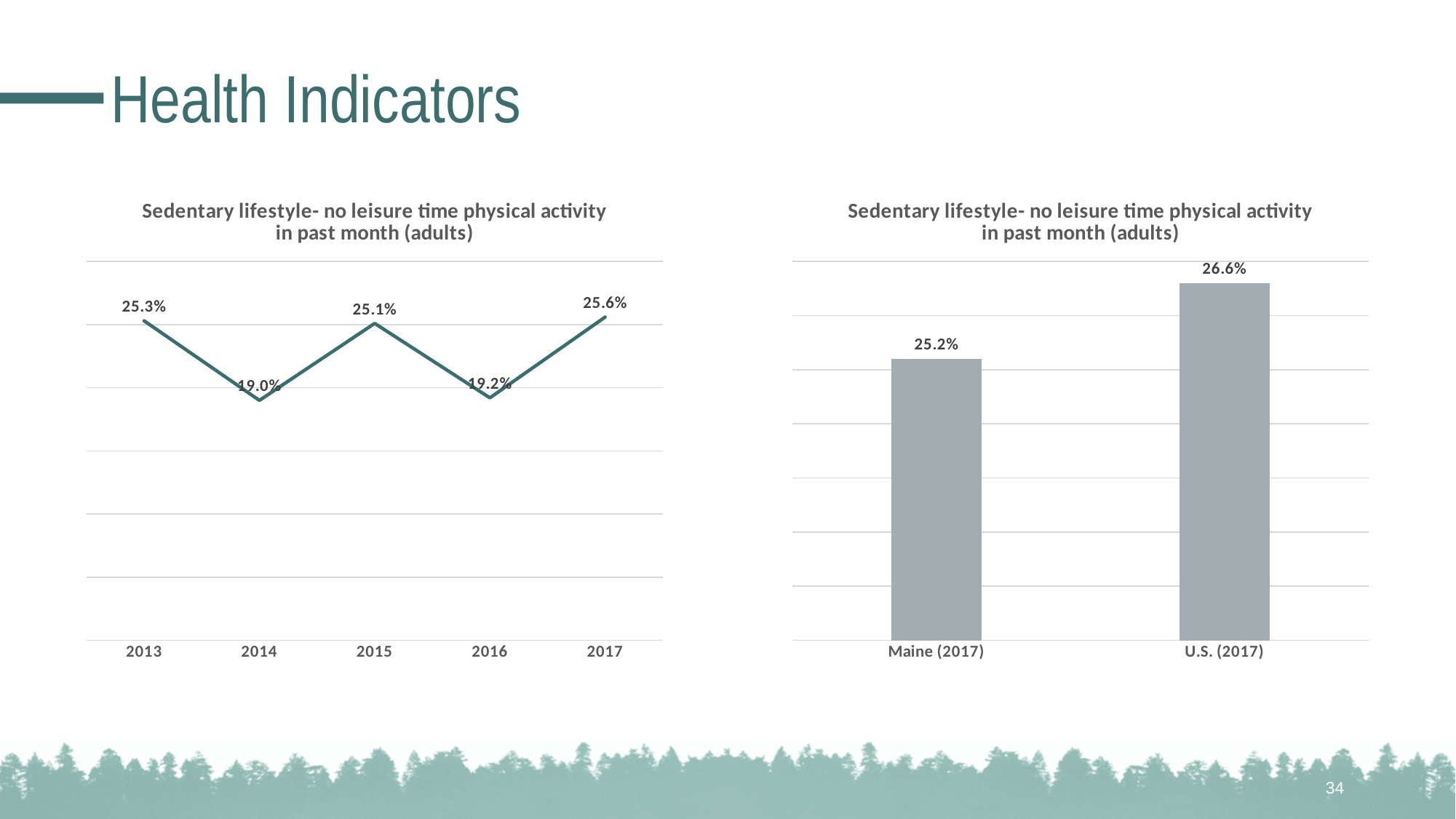
In the left chart, which year has the lowest value? 2014 In the left chart, does the value rise or fall from 2016 to 2017? Rise What kind of chart is the right chart? Bar chart In the left chart, what is the difference between the 2013 and 2014 values? 6.3% In the left chart, how many years are plotted on the x axis? 5 What kind of chart is the left chart? Line chart In the left chart, which year has the highest value? 2017 In the right chart, which is larger, Maine (2017) or U.S. (2017)? U.S. (2017) In the left chart, what is the value for 2017? 25.6% In the left chart, what is the value for 2014? 19.0% In the right chart, what is the difference between the U.S. (2017) and Maine (2017) values? 1.4% In the right chart, what is the value for Maine (2017)? 25.2%